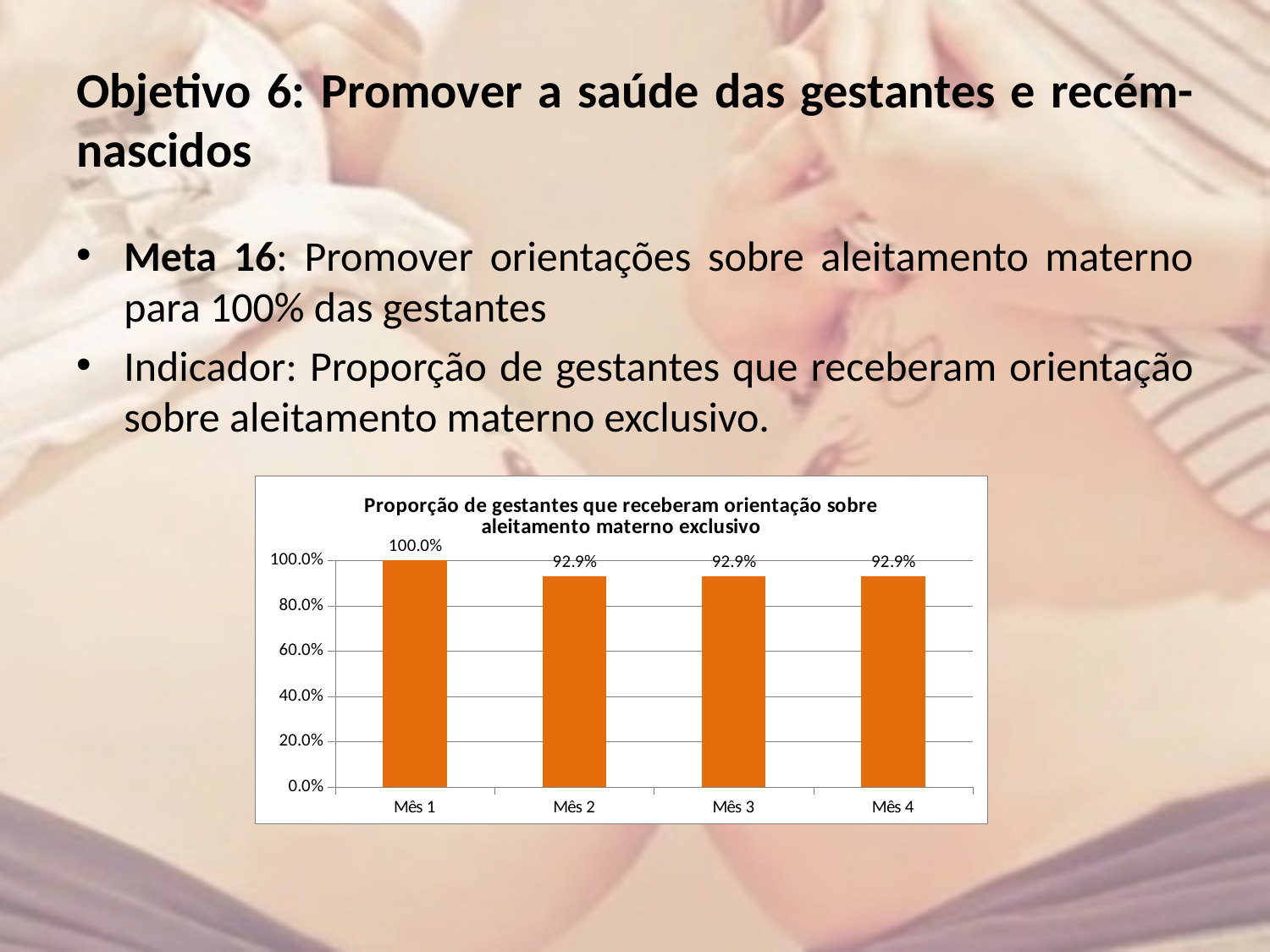
Which is larger, the value for Mês 1 or the value for Mês 2? Mês 1 What is the title of the chart? Proporção de gestantes que receberam orientação sobre aleitamento materno exclusivo Is the value for Mês 3 greater or less than 80.0%? greater What is the value for Mês 2? 92.9% What kind of chart is shown on the slide? bar chart What is the value for Mês 4? 92.9% What is the value for Mês 1? 100.0% How many months are shown on the x axis? 4 Which month has the highest value? Mês 1 What colour are the bars in the chart? orange Do the values rise or fall from Mês 1 to Mês 2? fall What is the difference between the values for Mês 1 and Mês 3? 7.1%